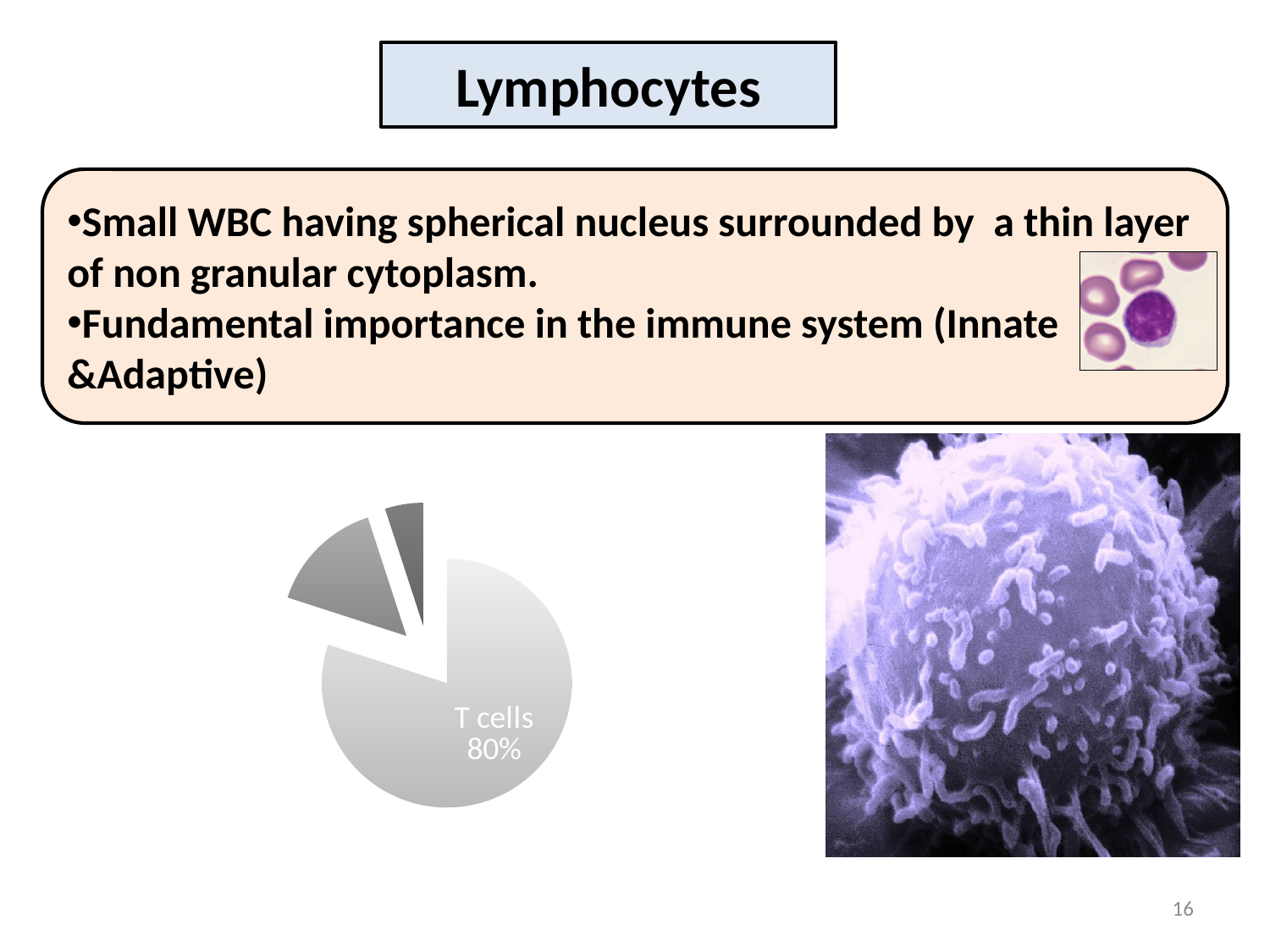
Is the T cells slice larger or smaller than half of the pie chart? larger What kind of chart is shown on the slide? pie chart Which slice of the pie chart has a printed data label? T cells How many slices does the pie chart have? 3 What share of the pie chart is labelled for T cells? 80% Which slice of the pie chart is the largest? T cells